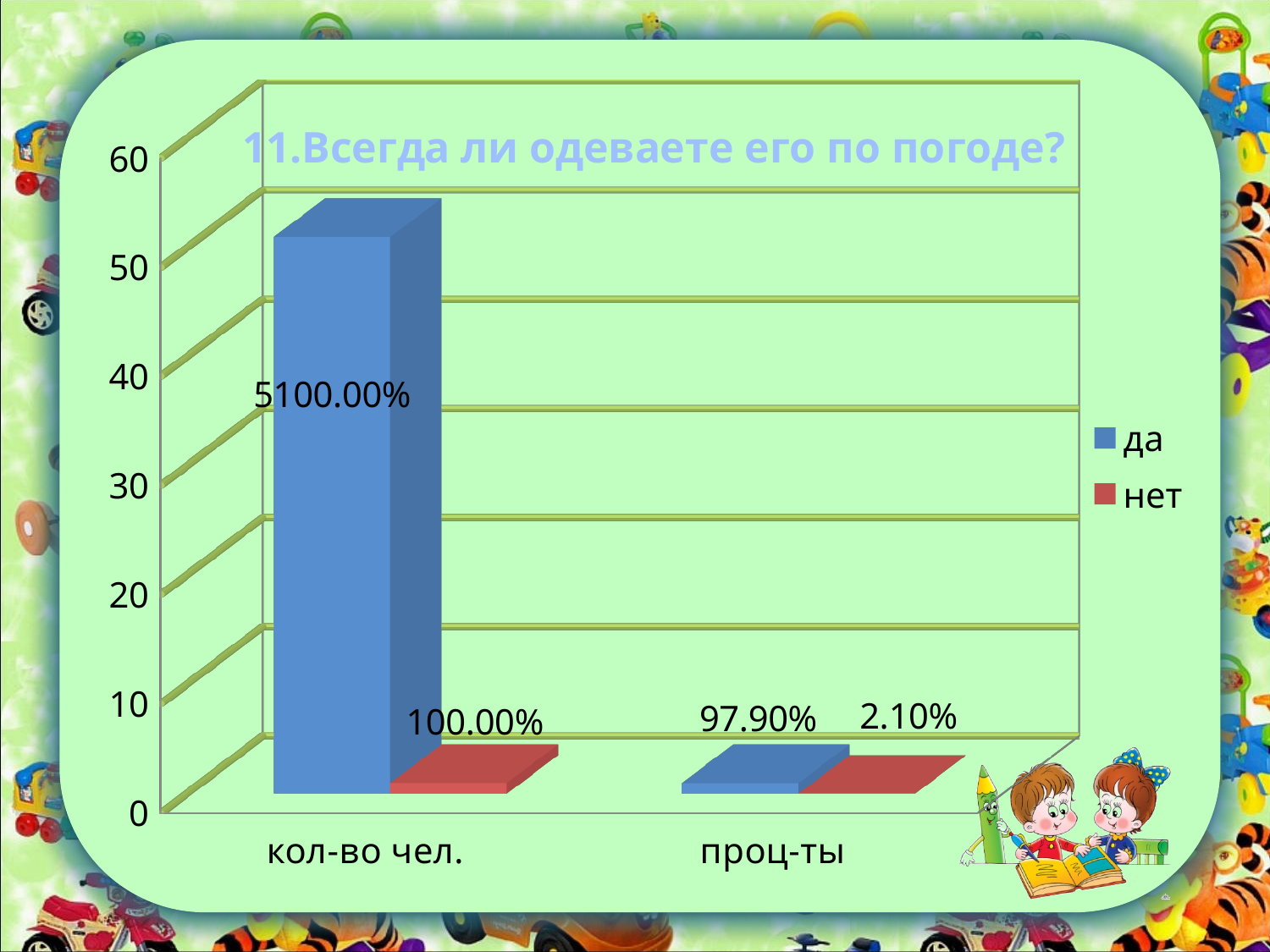
What kind of chart is shown on the slide? bar chart What are the two series named in the legend? да, нет How many categories are shown on the x axis? 2 What data label is shown for the 'нет' series in the 'кол-во чел.' category? 100.00% What data label is shown for the 'да' series in the 'кол-во чел.' category? 5100.00% What is the title of the chart? 11.Всегда ли одеваете его по погоде? What data label is shown for the 'нет' series in the 'проц-ты' category? 2.10% How many series does the legend list? 2 What data label is shown for the 'да' series in the 'проц-ты' category? 97.90% In the 'проц-ты' category, what is the difference between the 'да' and 'нет' labels? 95.80% Which series has the taller bar in the 'кол-во чел.' category, 'да' or 'нет'? да Is the 'да' bar for 'кол-во чел.' greater or less than 40 on the axis? greater